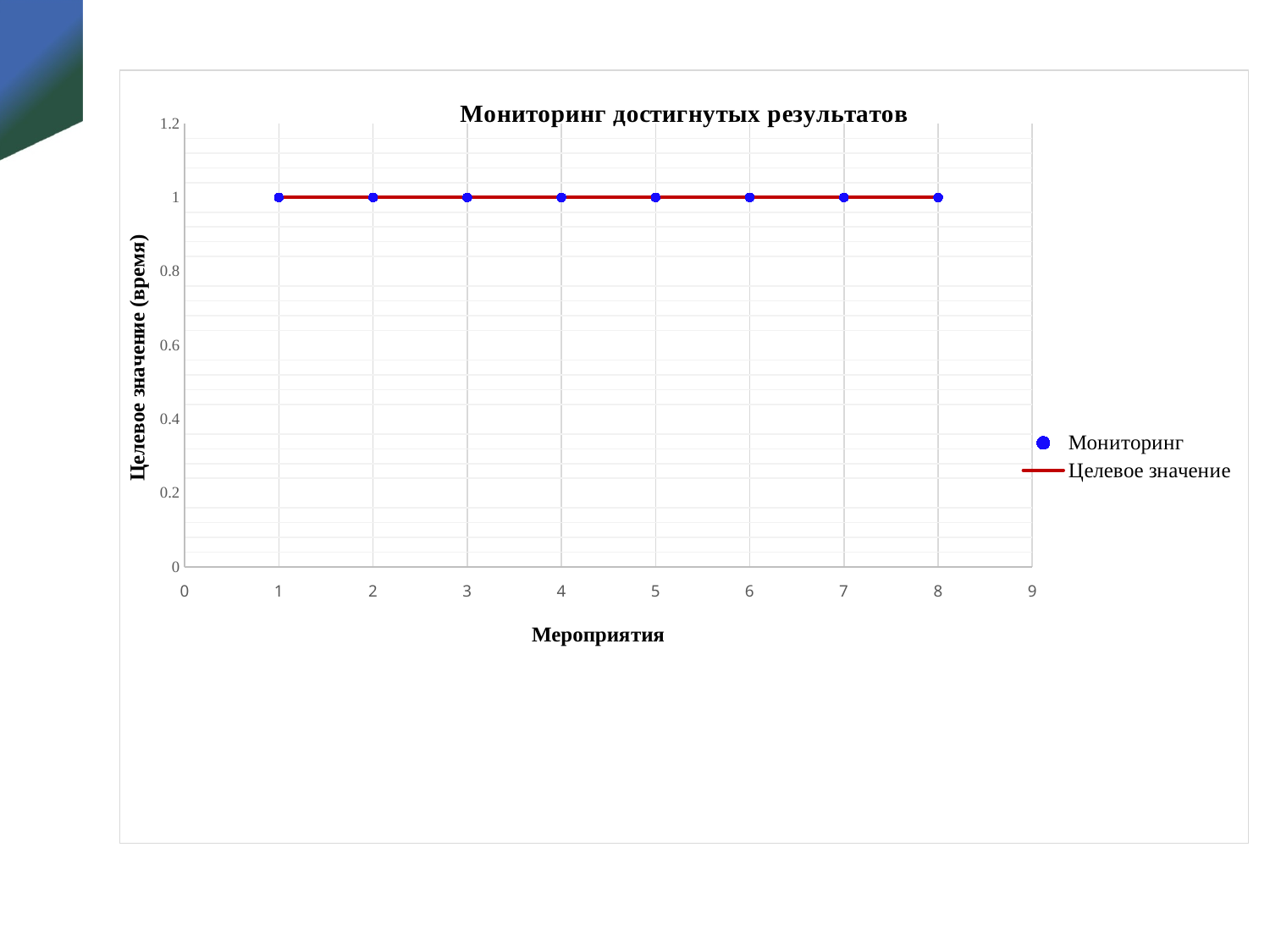
Is the value for Мониторинг at Мероприятие 4 greater or less than 0.8? greater What are the names of the series in the legend? Мониторинг, Целевое значение What is the difference between the Мониторинг value at Мероприятие 3 and the Целевое значение at Мероприятие 3? 0 Do the Мониторинг values rise, fall, or stay flat from Мероприятие 1 to 8? stay flat What is the value of the Мониторинг series at Мероприятие 8? 1 What is the value of the Целевое значение line at Мероприятие 5? 1 What is the label of the x axis? Мероприятия How many series does the legend list? 2 What is the value of the Мониторинг series at Мероприятие 1? 1 What is the title of the chart? Мониторинг достигнутых результатов How many data points are plotted for the Мониторинг series? 8 Is the value for Мониторинг at Мероприятие 2 greater or less than 1.2? less